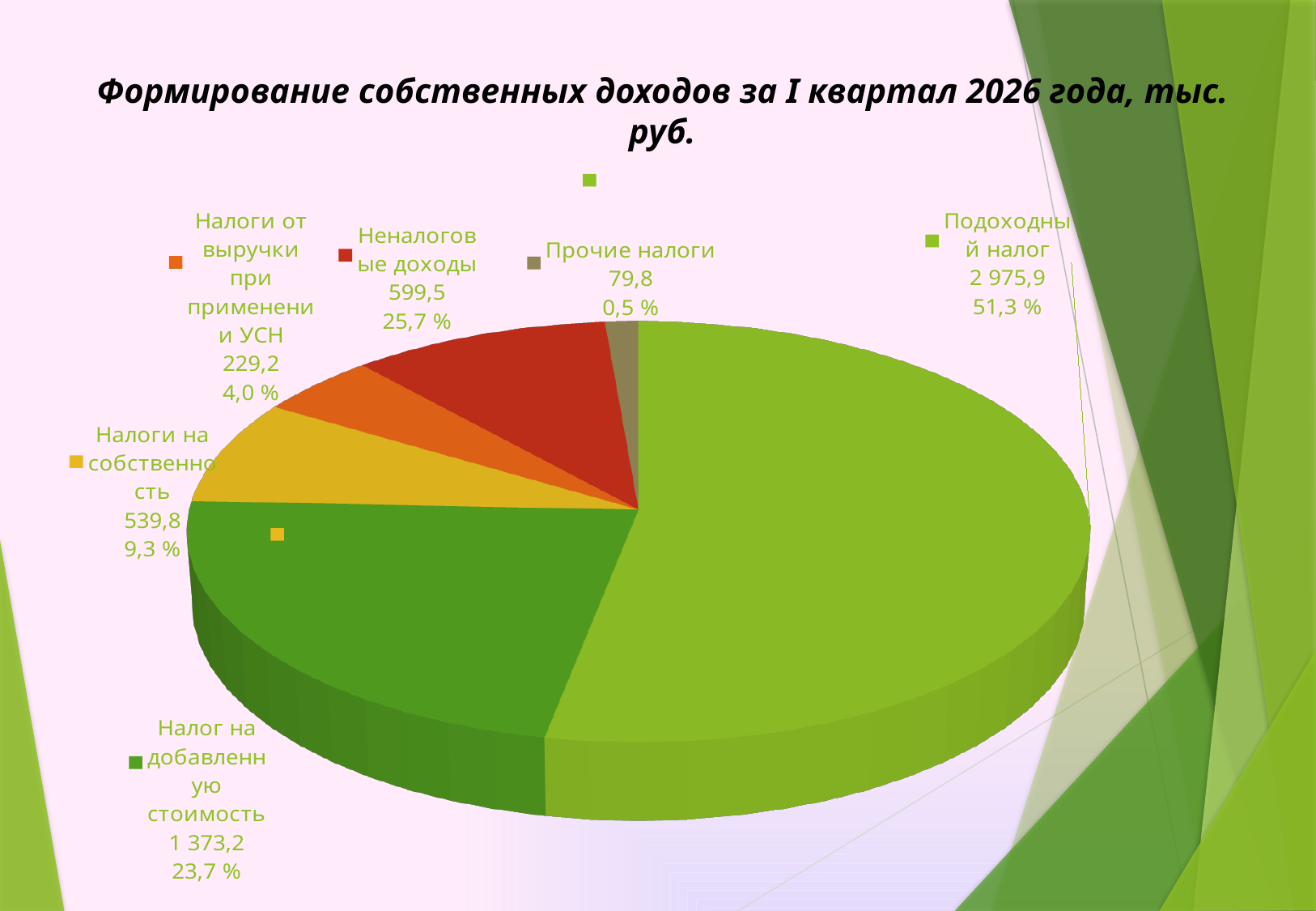
How many categories are shown in the pie chart? 6 What is the value for Налоги на собственность? 539,8 What is the value for Налог на добавленную стоимость? 1 373,2 What is the value for Неналоговые доходы? 599,5 What kind of chart is shown on the slide? pie chart Which category has the smallest slice of the pie? Прочие налоги Which category has the largest slice of the pie? Подоходный налог What is the difference between the values for Подоходный налог and Налог на добавленную стоимость? 1 602,7 What share of the pie does Подоходный налог represent? 51,3 % What is the value for Подоходный налог? 2 975,9 What share of the pie does Налог на добавленную стоимость represent? 23,7 % What is the value for Прочие налоги? 79,8